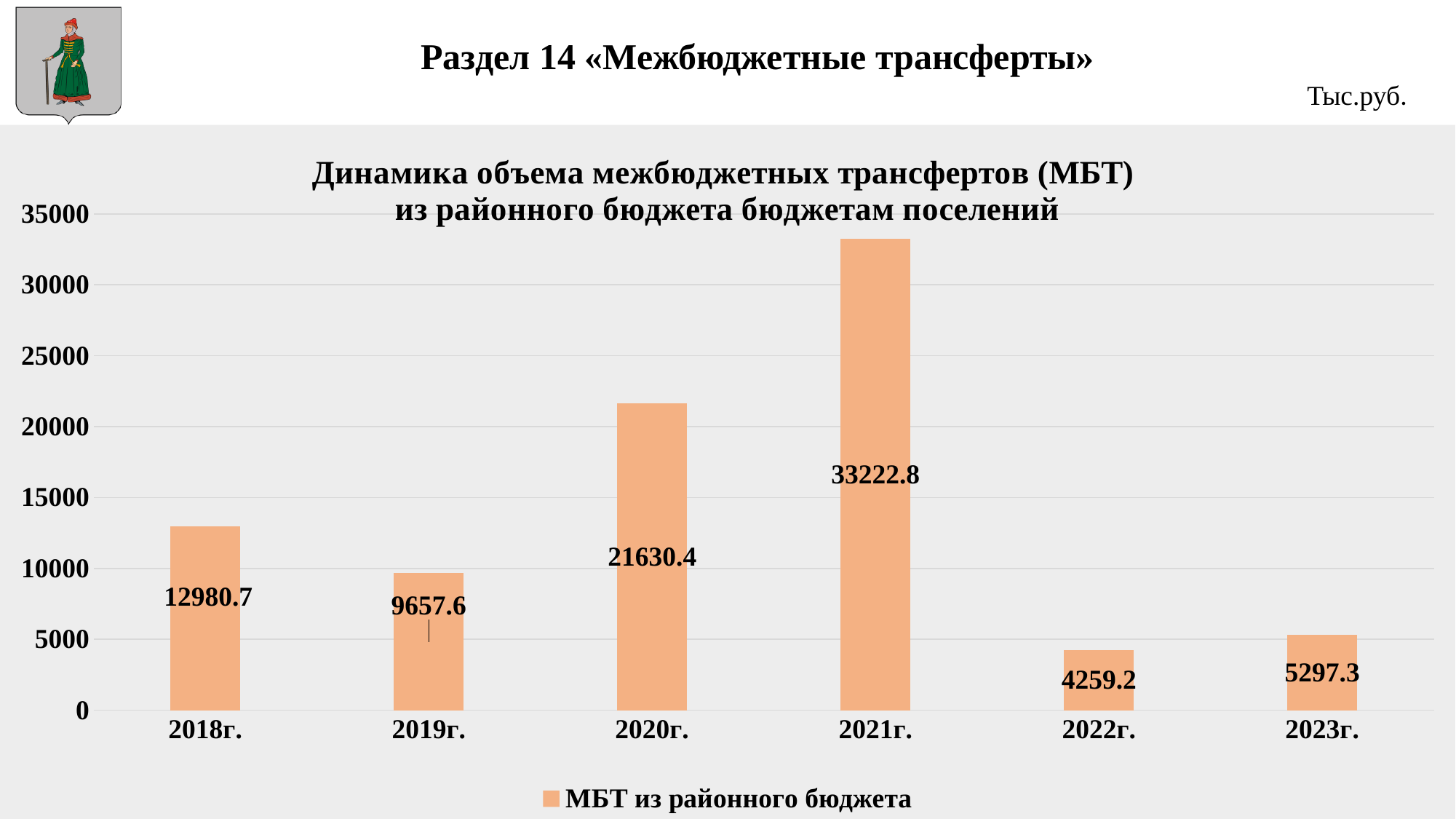
Is the value for 2020г. greater or less than 20000? greater What is the difference between the values for 2021г. and 2020г.? 11592.4 What is the value for 2021г.? 33222.8 How many years are shown on the x axis? 6 What kind of chart is shown on the slide? bar chart What is the value for 2019г.? 9657.6 What is the value for 2023г.? 5297.3 Which year has the lowest value? 2022г. Which is larger, the value for 2018г. or the value for 2019г.? 2018г. What is the legend entry for the series shown? МБТ из районного бюджета Which year has the highest value? 2021г. What is the difference between the values for 2023г. and 2022г.? 1038.1